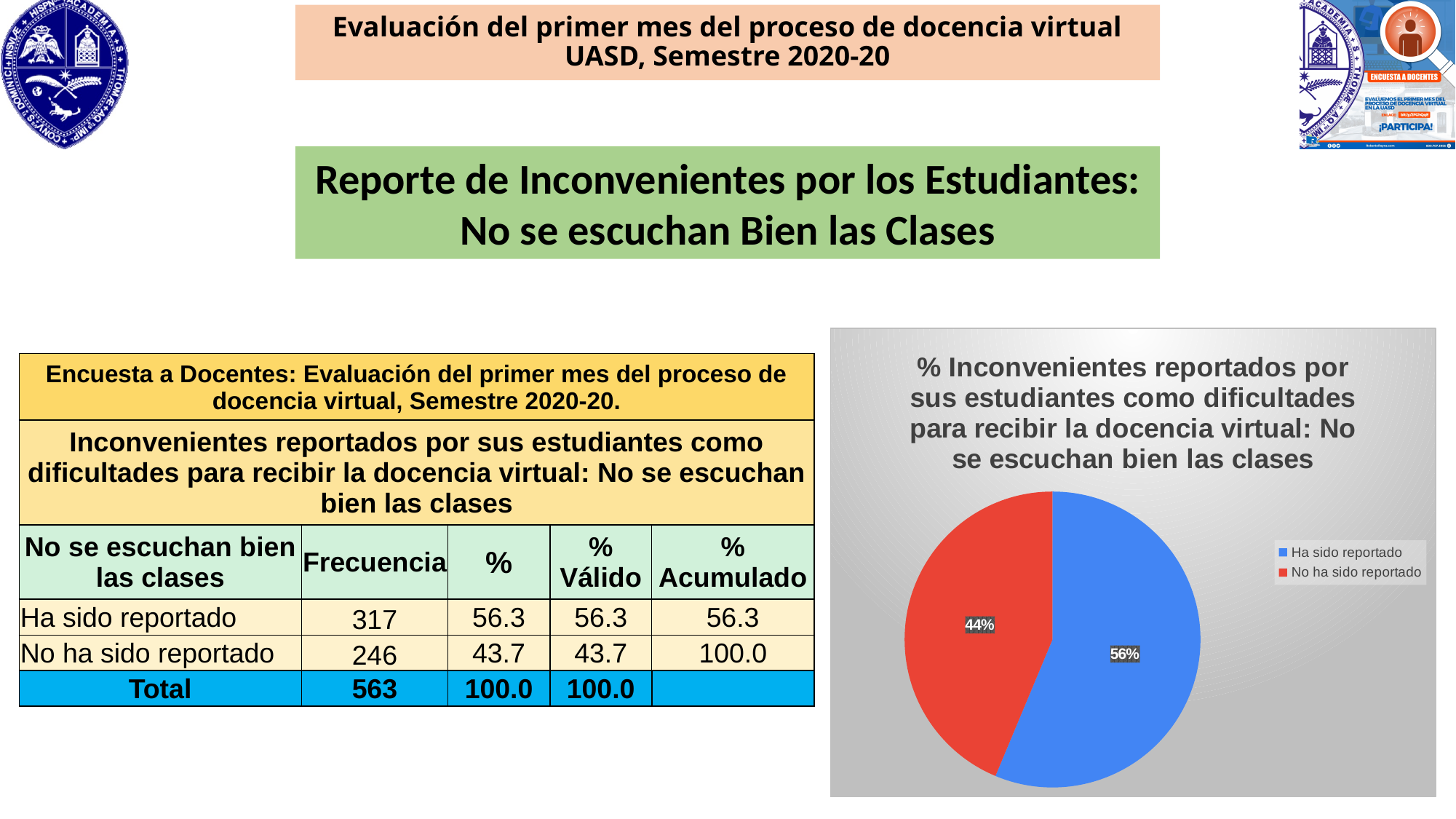
How many entries does the pie chart's legend list? 2 Which category has the smallest slice in the pie chart? No ha sido reportado How many slices does the pie chart have? 2 Which slice is larger in the pie chart, "Ha sido reportado" or "No ha sido reportado"? Ha sido reportado What colour is the "No ha sido reportado" slice in the pie chart? red What colour is the "Ha sido reportado" slice in the pie chart? blue By how many percentage points does "Ha sido reportado" exceed "No ha sido reportado" in the pie chart? 12% Which category has the largest slice in the pie chart? Ha sido reportado What percentage does the pie chart show for "Ha sido reportado"? 56% What percentage does the pie chart show for "No ha sido reportado"? 44% What type of chart is shown on the slide? pie chart What share of the pie does the "No ha sido reportado" slice represent? 44%